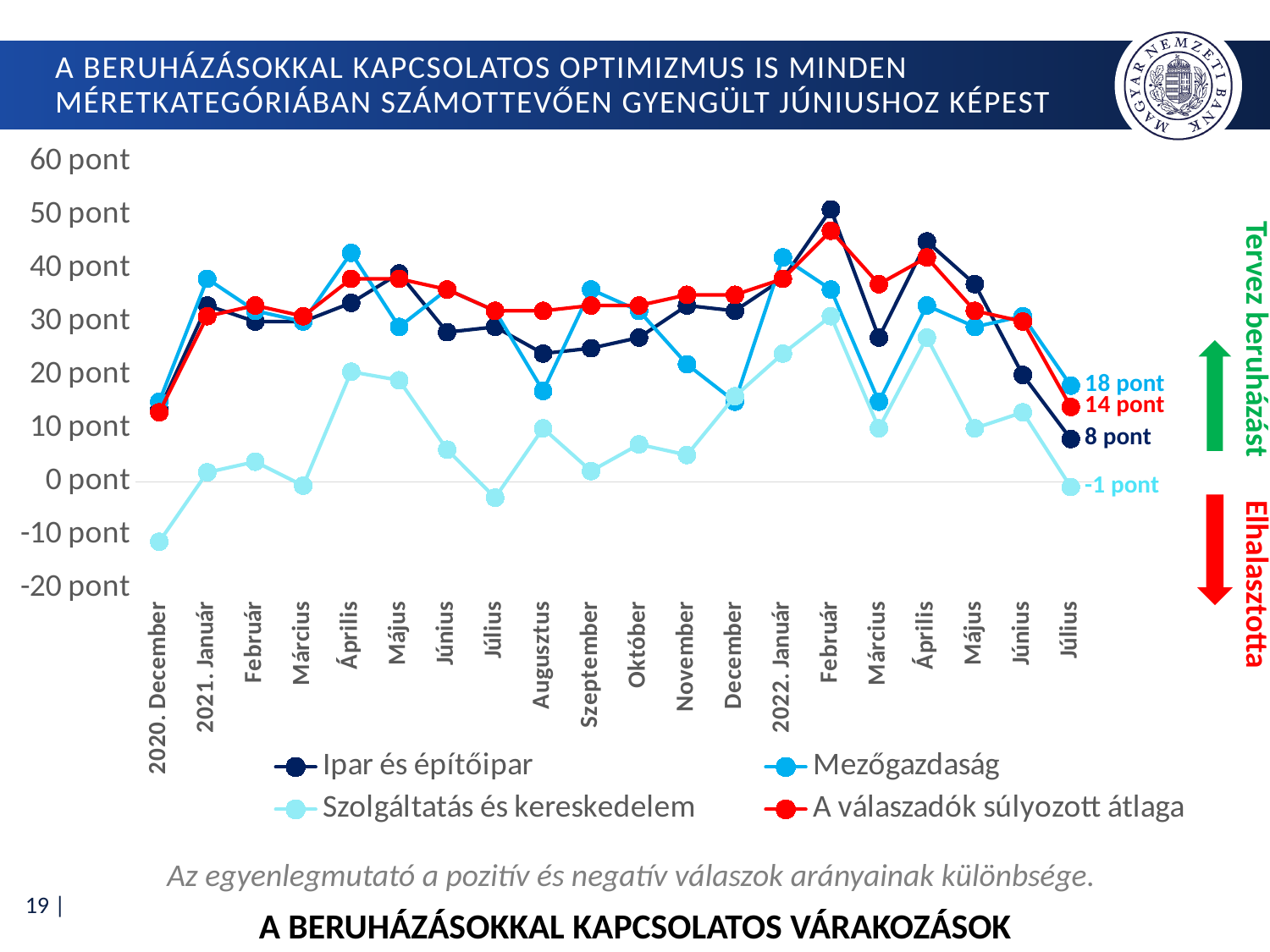
What kind of chart is shown on the slide? Line chart In 2022 Július, which is larger: Mezőgazdaság or Ipar és építőipar? Mezőgazdaság Which series has the lowest value in 2022 Július? Szolgáltatás és kereskedelem What is the value for Ipar és építőipar in 2022 Július? 8 pont What is the value for Mezőgazdaság in 2022 Július? 18 pont What is the value for A válaszadók súlyozott átlaga in 2022 Július? 14 pont What is the value for Szolgáltatás és kereskedelem in 2022 Július? -1 pont Which series has the highest value in 2022 Július? Mezőgazdaság In 2022 Július, how much higher is Mezőgazdaság than Ipar és építőipar? 10 pont Is the value for Ipar és építőipar in 2022 Február greater or less than 40 pont? greater How many months are shown on the x axis? 20 How many series does the legend list? 4